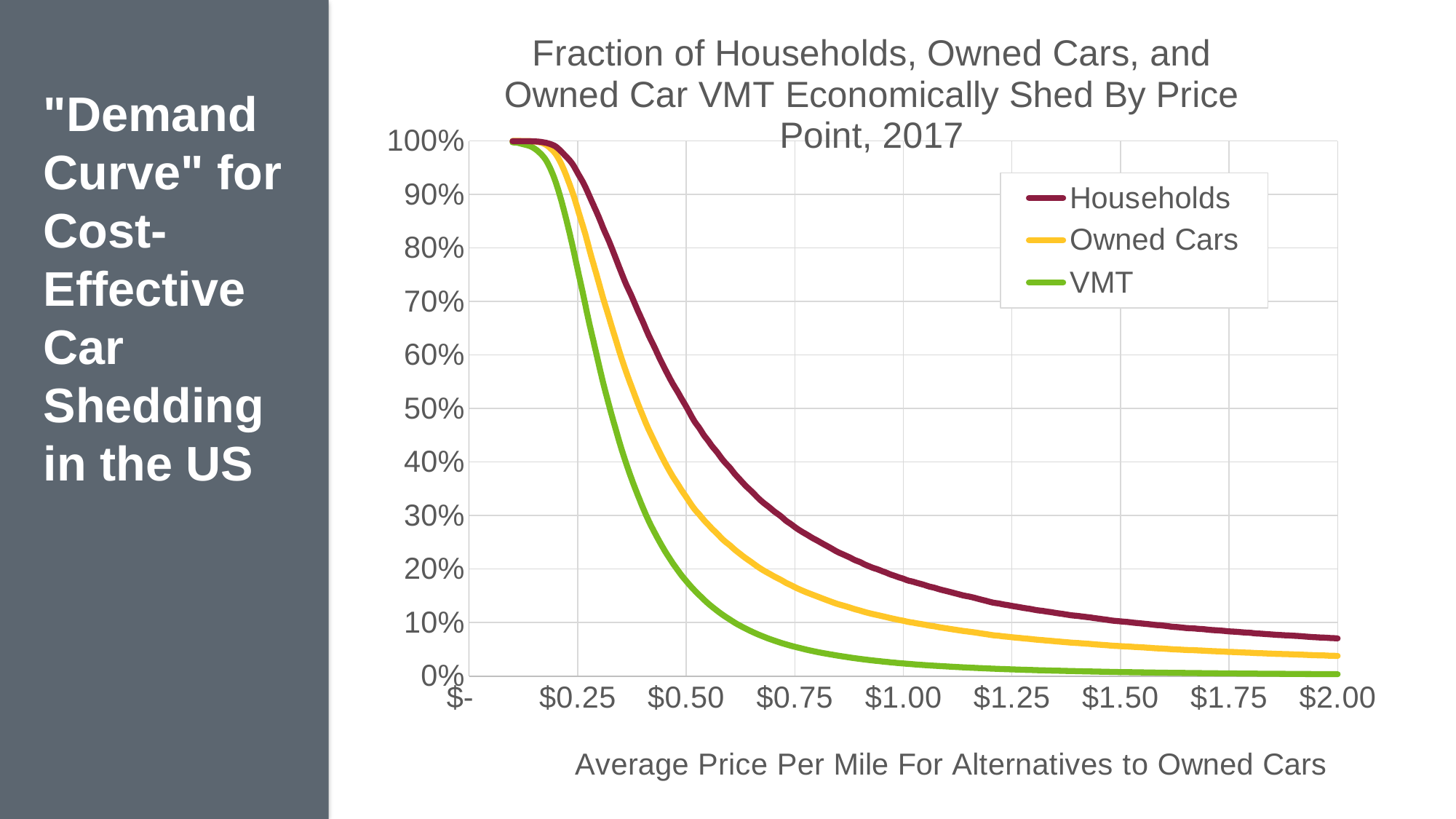
Is the value for Owned Cars at $2.00 greater or less than 10%? less What kind of chart is shown on the slide? line chart Do the values of the Households series rise or fall as the price per mile increases? fall Is the value for VMT at $1.00 greater or less than 10%? less Which series has the highest value at $1.50 per mile? Households Which series has the lowest value at $0.75 per mile? VMT How many series does the legend list? 3 Which series are listed in the legend? Households, Owned Cars, VMT Is the value for Households at $2.00 greater or less than 10%? less What is the label of the x axis? Average Price Per Mile For Alternatives to Owned Cars At $1.00 per mile, which is larger, the Households value or the VMT value? Households